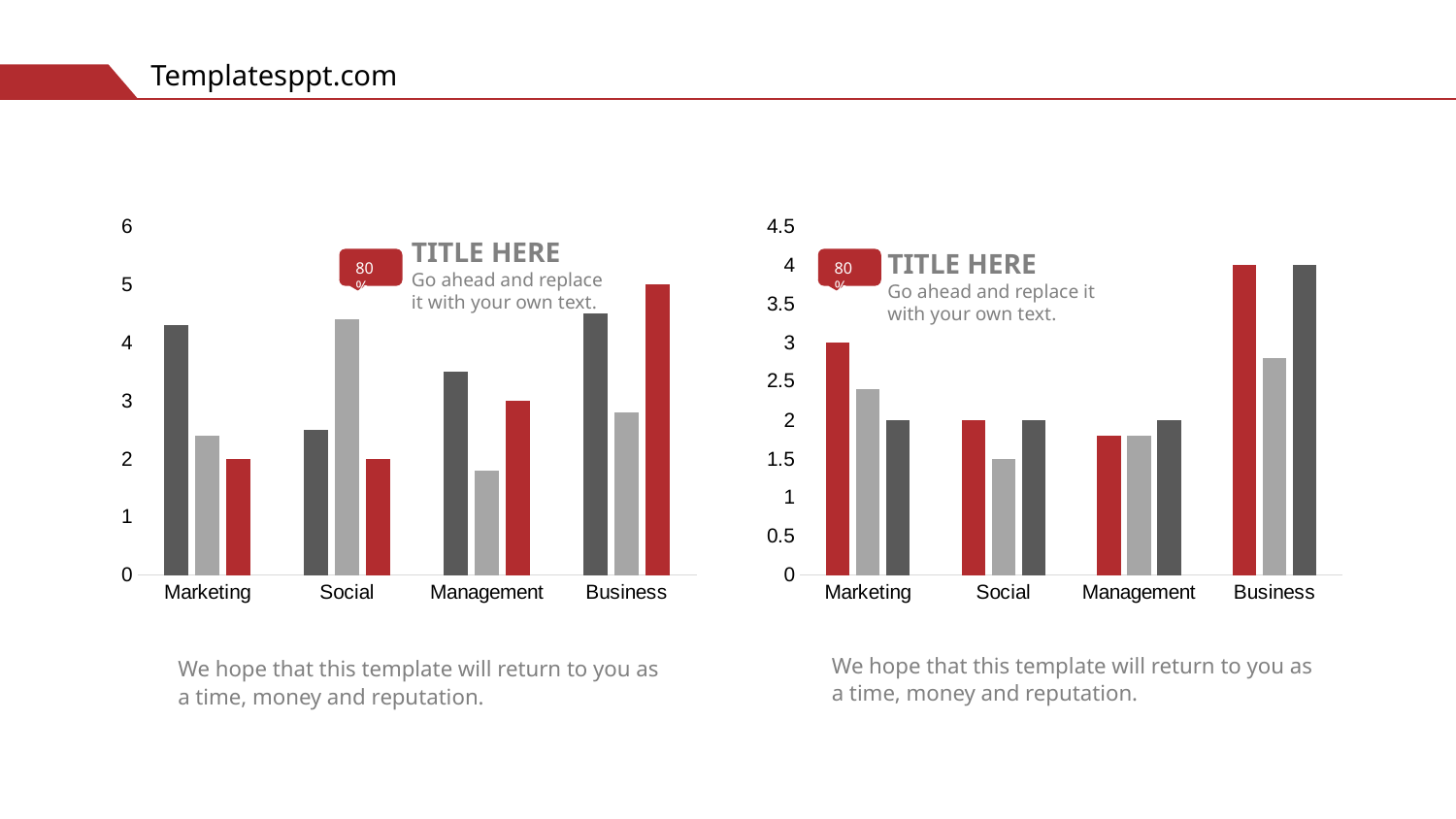
In the chart on the right, is the value of the grey bar for Business greater or less than 2.5? greater In the chart on the left, what is the value of the red bar for Business? 5 In the chart on the left, which category has the tallest red bar? Business In the chart on the left, which is larger: the dark grey bar for Marketing or the dark grey bar for Social? Marketing In the chart on the right, what is the value of the red bar for Marketing? 3 In the chart on the right, which category has the shortest light grey bar? Social How many categories are shown on the x axis of the chart on the right of the slide? 4 What is the highest value shown on the y axis of the chart on the right? 4.5 What kind of chart is the chart on the left of the slide? bar chart In the chart on the right, which category has the tallest red bar? Business